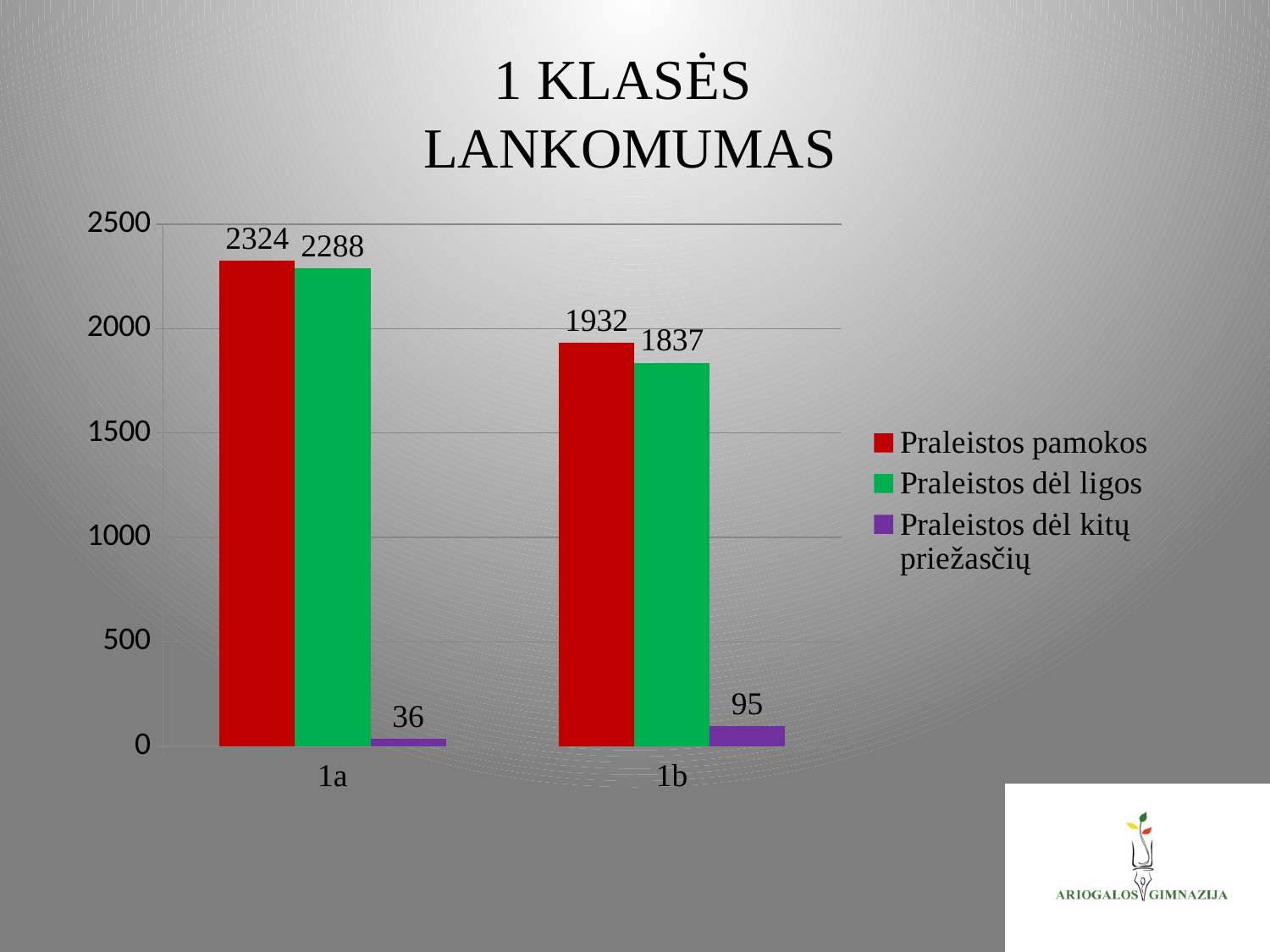
Which class has the higher value for Praleistos pamokos? 1a What is the value of Praleistos dėl kitų priežasčių for 1b? 95 What is the value of Praleistos dėl kitų priežasčių for 1a? 36 What is the difference between Praleistos pamokos and Praleistos dėl ligos for 1b? 95 What is the value of Praleistos pamokos for 1a? 2324 What is the difference between Praleistos pamokos for 1a and 1b? 392 How many classes are shown on the x axis? 2 How many series does the legend list? 3 What is the value of Praleistos dėl ligos for 1b? 1837 Which class has the lower value for Praleistos dėl kitų priežasčių? 1a Is Praleistos dėl ligos larger for 1a or 1b? 1a What kind of chart is shown on the slide? bar chart